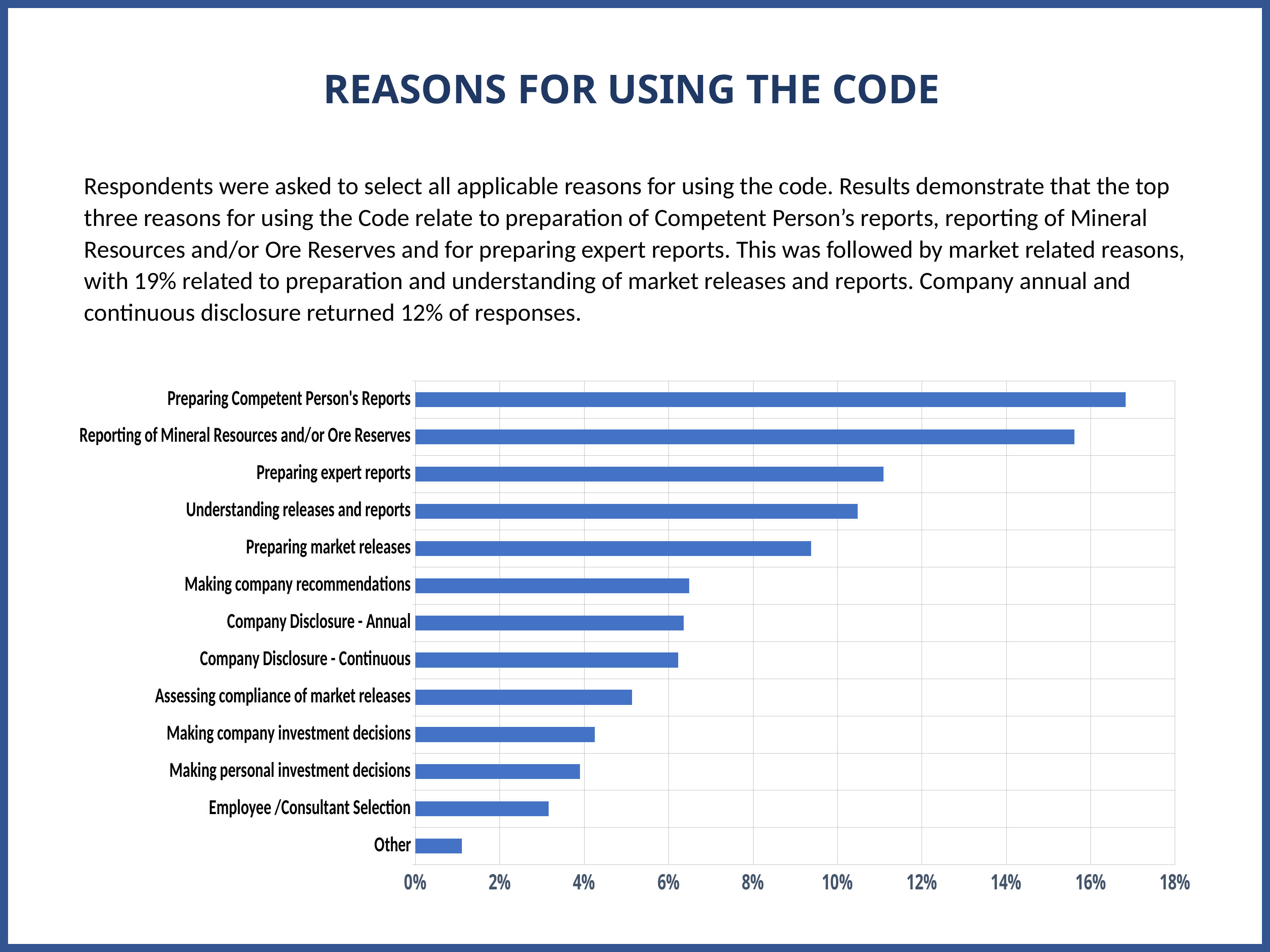
Is the value for Preparing market releases greater or less than 10%? less Which is larger, the value for Assessing compliance of market releases or the value for Employee /Consultant Selection? Assessing compliance of market releases How many reasons (categories) are plotted in the chart? 13 Which reason has the lowest value in the chart? Other Which reason has the highest value in the chart? Preparing Competent Person's Reports Is the value for Other greater or less than 2%? less What kind of chart is shown on the slide? bar chart Which is larger, the value for Preparing expert reports or the value for Preparing market releases? Preparing expert reports Is the value for Reporting of Mineral Resources and/or Ore Reserves greater or less than 16%? less What is the title of the slide containing the chart? REASONS FOR USING THE CODE